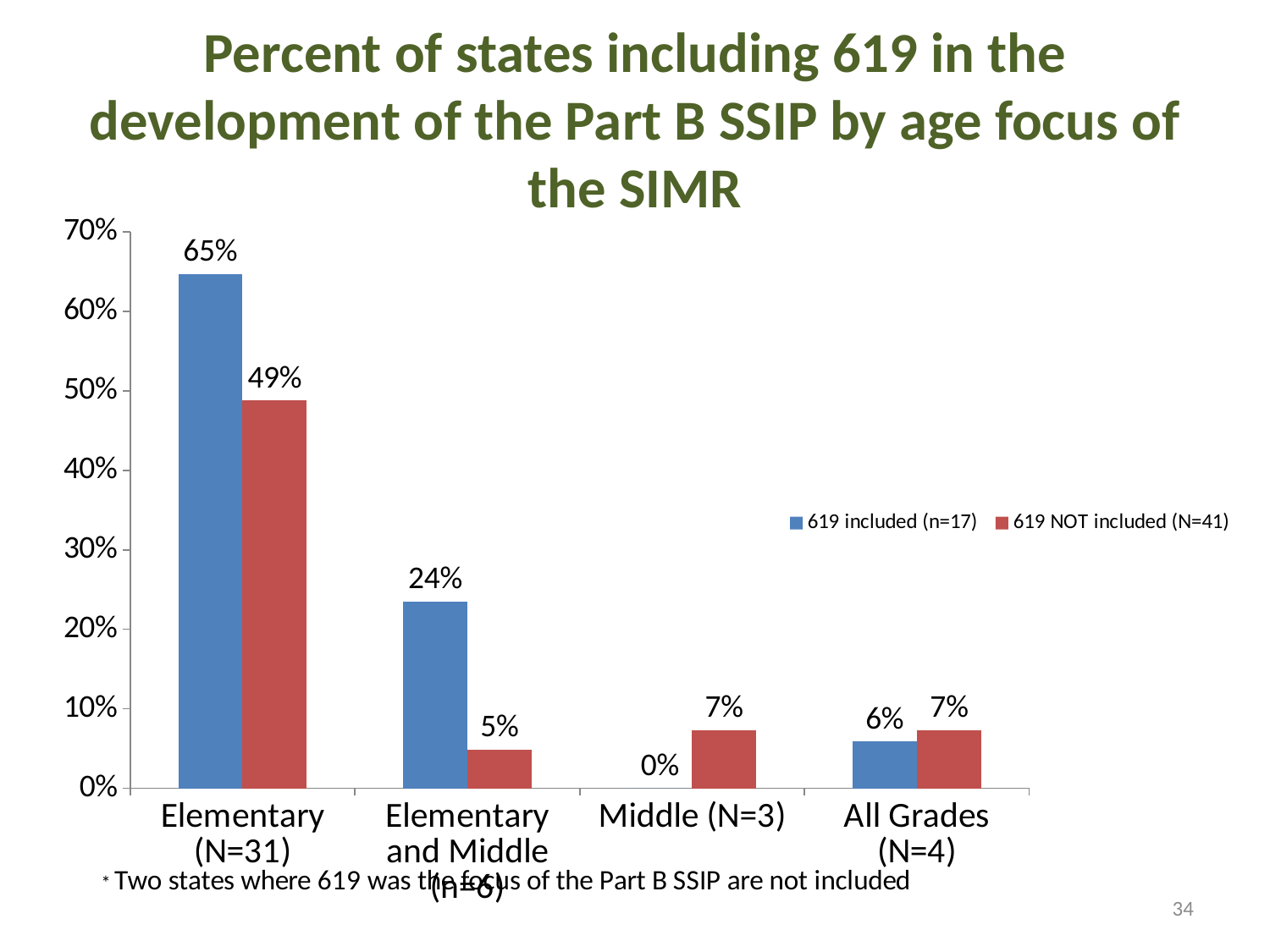
What is the value for Elementary (N=31) in the 619 included (n=17) series? 65% Is the value for Elementary (N=31) in the 619 included (n=17) series greater or less than 60%? greater What is the value for Elementary and Middle in the 619 NOT included (N=41) series? 5% How many series does the legend list? 2 What is the value for Middle (N=3) in the 619 included (n=17) series? 0% What kind of chart is shown on the slide? bar chart What colour are the bars for the 619 NOT included (N=41) series? red Which category has the lowest value in the 619 included (n=17) series? Middle (N=3) How many categories are shown on the x axis? 4 What is the difference between the 619 included and 619 NOT included values for Elementary (N=31)? 16% For Elementary and Middle, which series has the larger value: 619 included (n=17) or 619 NOT included (N=41)? 619 included (n=17) Which category has the highest value in the 619 NOT included (N=41) series? Elementary (N=31)